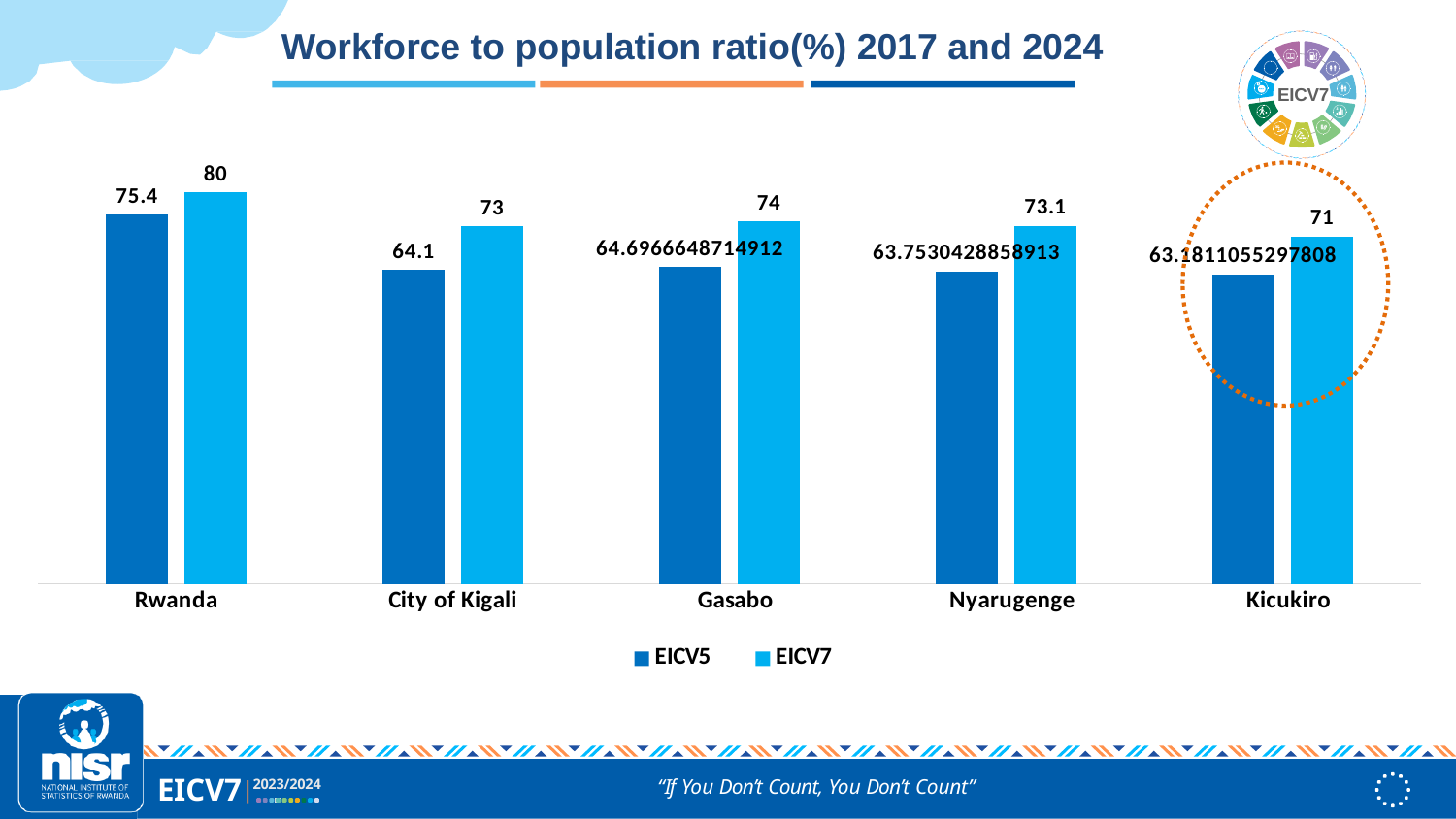
What is the difference between the EICV7 and EICV5 values for Rwanda? 4.6 Which category has the lowest EICV7 value? Kicukiro What is the EICV5 value for Rwanda? 75.4 Which category has the highest EICV7 value? Rwanda How many series does the legend list? 2 What is the EICV7 value for Rwanda? 80 What is the EICV5 value for City of Kigali? 64.1 How many categories are shown on the x axis? 5 Which is larger for Gasabo, the EICV5 value or the EICV7 value? EICV7 What is the EICV7 value for Nyarugenge? 73.1 What is the EICV7 value for City of Kigali? 73 What is the EICV7 value for Kicukiro? 71